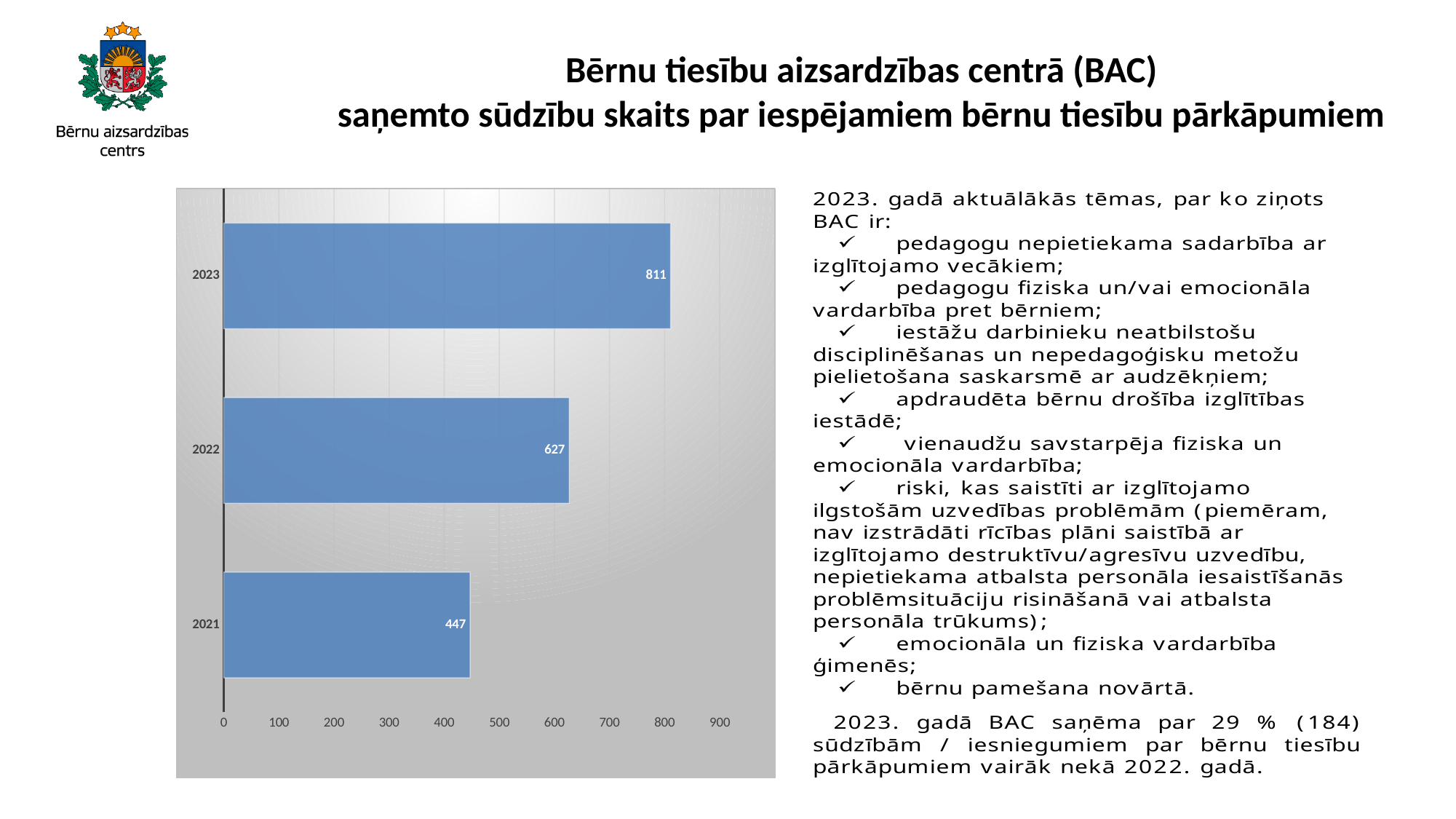
Which year has the lowest value? 2021 What is the difference between the values for 2022 and 2021? 180 How many years are shown in the chart? 3 Is the value for 2023 greater or less than 800? greater What kind of chart is shown on the slide? bar chart What is the difference between the values for 2023 and 2022? 184 Which is larger, the value for 2022 or the value for 2021? 2022 What is the value for 2023? 811 What is the value for 2022? 627 Which year has the highest value? 2023 Do the values rise or fall from 2021 to 2023? rise What is the value for 2021? 447